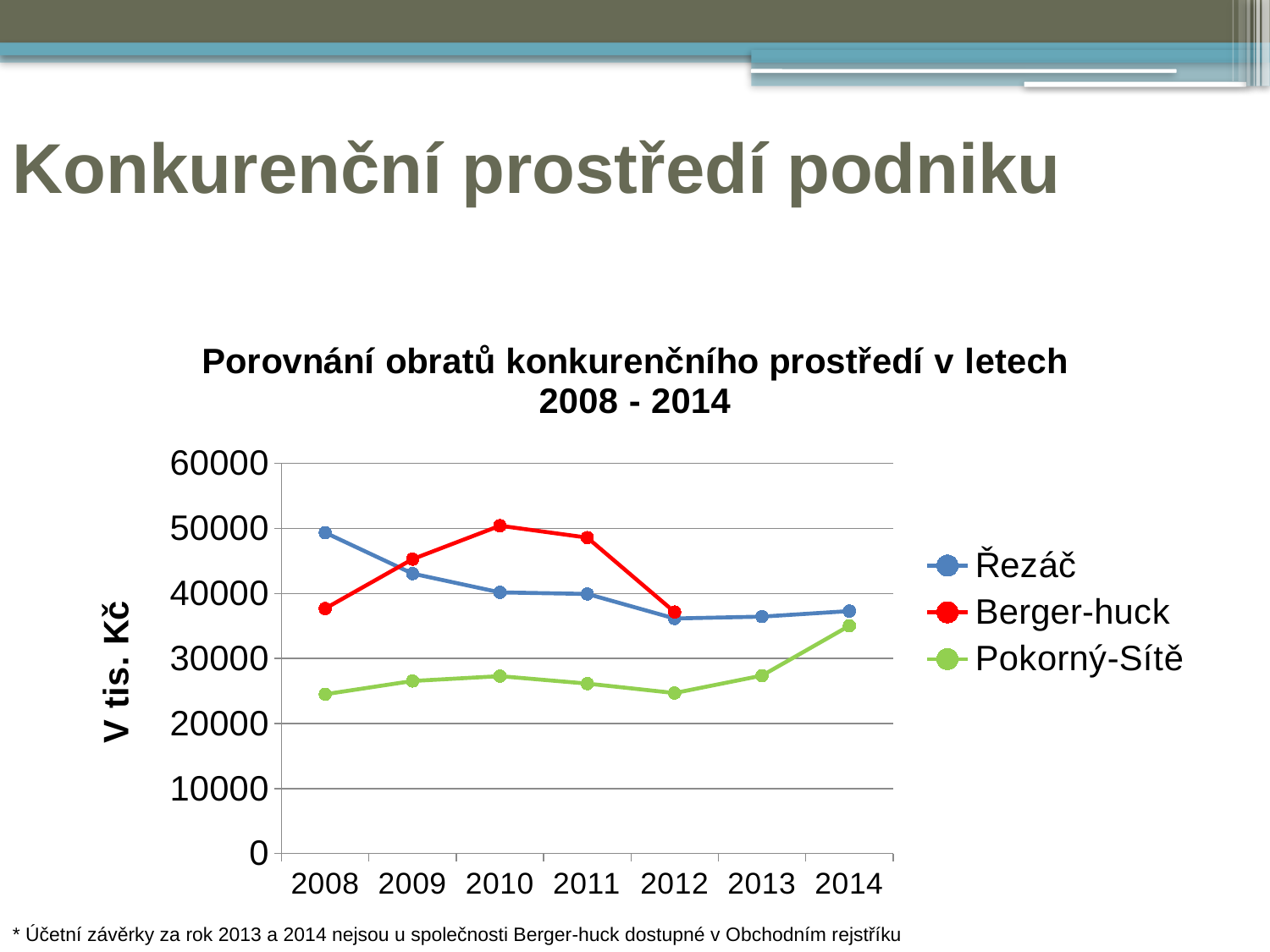
In which year does Berger-huck reach its highest value? 2010 Does the value for Řezáč rise or fall from 2008 to 2012? fall What kind of chart is shown on the slide? line chart Is the value for Pokorný-Sítě in 2008 greater or less than 30000? less Is the value for Řezáč in 2008 greater or less than 40000? greater In 2010, which series has the higher value, Berger-huck or Řezáč? Berger-huck How many years are shown on the x axis? 7 How many series does the legend list? 3 Which series has the lowest value in 2012? Pokorný-Sítě In 2008, which series has the higher value, Řezáč or Berger-huck? Řezáč Is the value for Berger-huck in 2010 greater or less than 40000? greater What is the label of the vertical axis? V tis. Kč